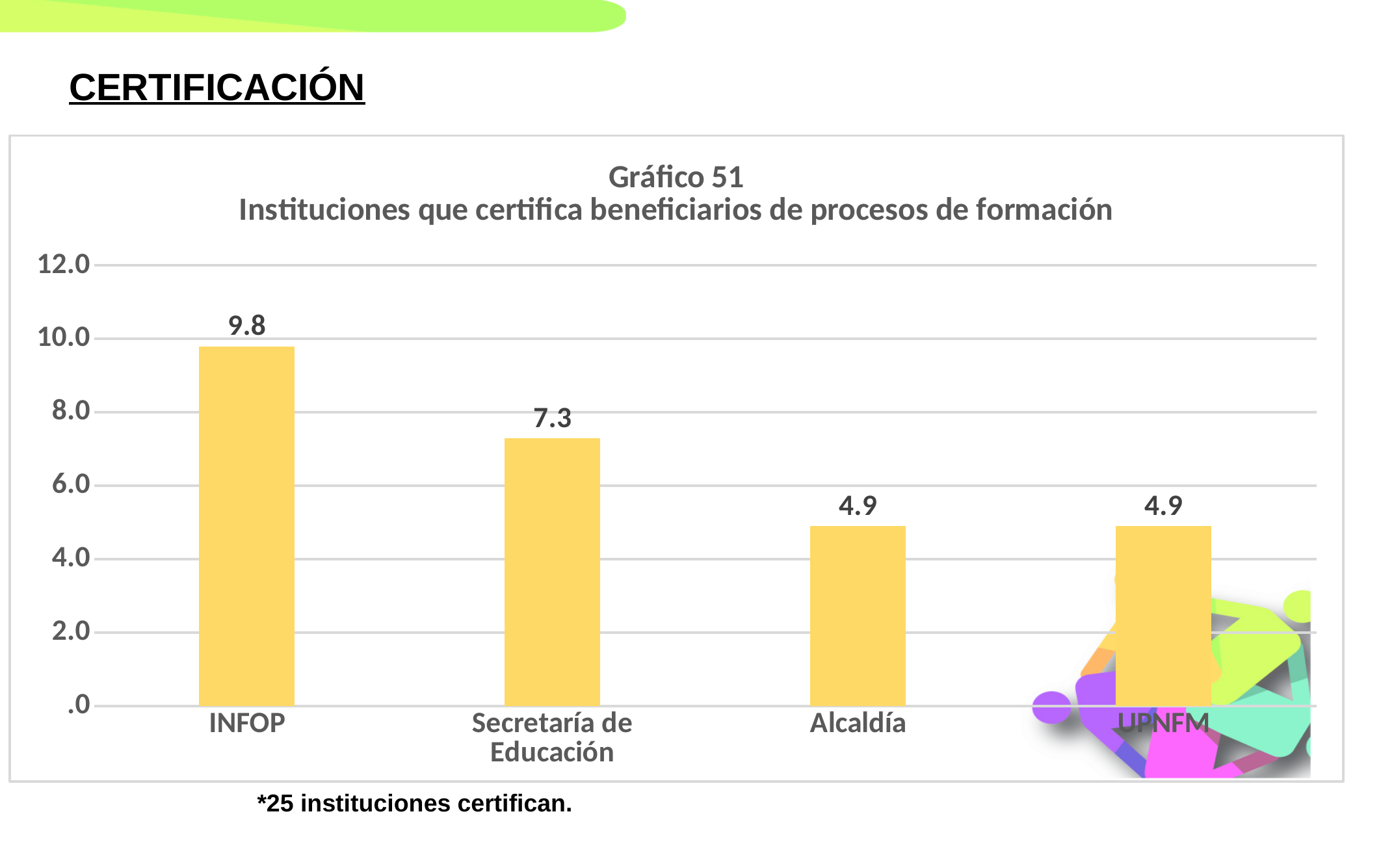
What is the value for Alcaldía? 4.9 What is the difference between the values for INFOP and Secretaría de Educación? 2.5 Which is larger, the value for INFOP or the value for Alcaldía? INFOP What is the title of the chart? Gráfico 51 Instituciones que certifica beneficiarios de procesos de formación Which institution has the highest value? INFOP What is the value for Secretaría de Educación? 7.3 Is the value for Secretaría de Educación greater or less than 8.0? less What is the value for INFOP? 9.8 How many institutions are shown on the chart? 4 What kind of chart is shown on the slide? bar chart What is the value for UPNFM? 4.9 What is the difference between the values for Secretaría de Educación and Alcaldía? 2.4